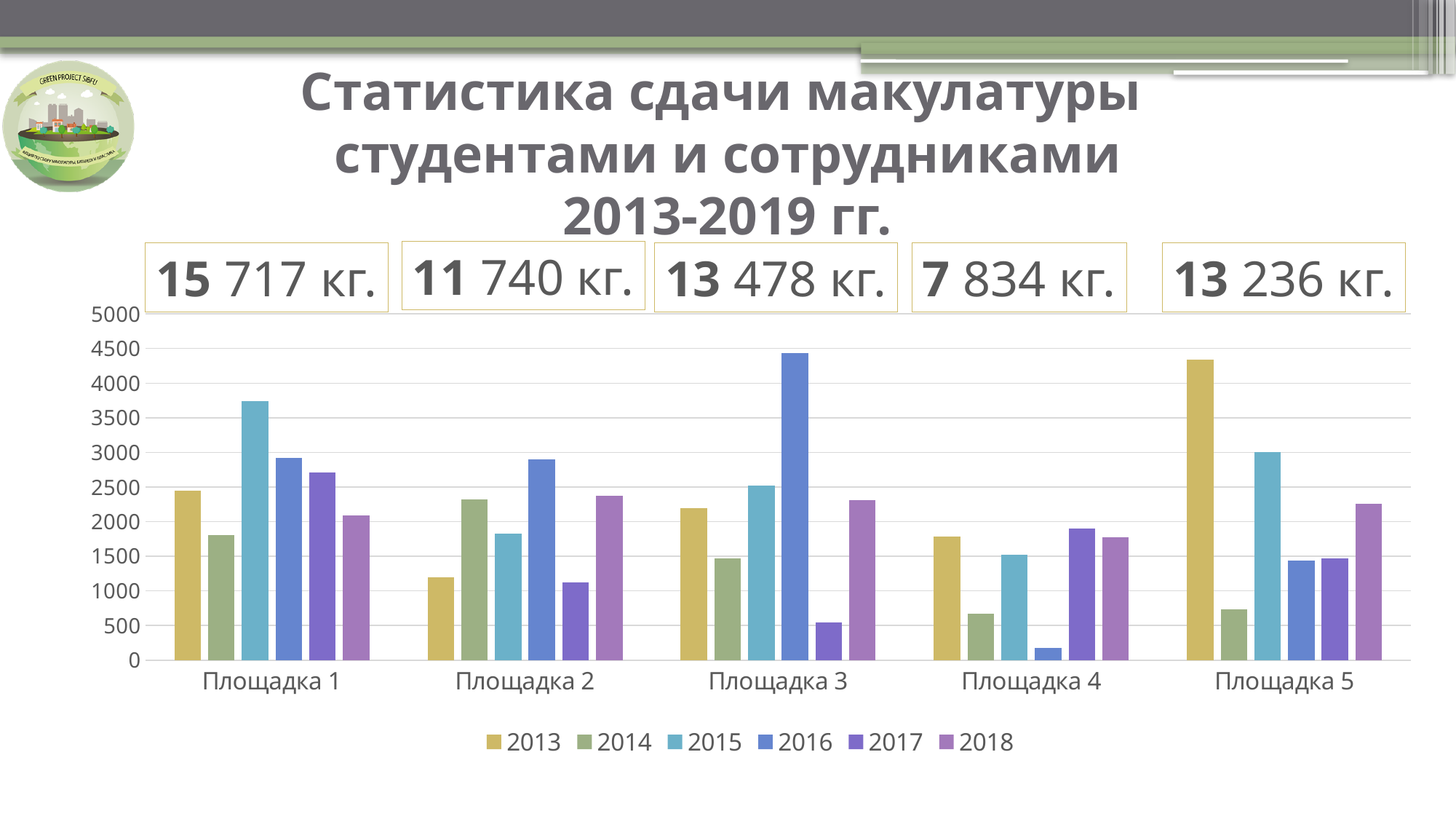
Is the value for 2016 at Площадка 3 greater or less than 4000? greater What kind of chart is shown on the slide? bar chart Is the value for 2013 at Площадка 5 greater or less than 4000? greater Is the value for 2016 at Площадка 4 greater or less than 500? less Which year has the lowest bar at Площадка 3? 2017 What total is printed in the box above Площадка 4? 7 834 кг. At Площадка 2, which is larger: the value for 2014 or the value for 2015? 2014 Which year has the highest bar at Площадка 5? 2013 How many categories (площадки) are shown on the x axis? 5 Which year has the highest bar at Площадка 1? 2015 How many series does the legend list? 6